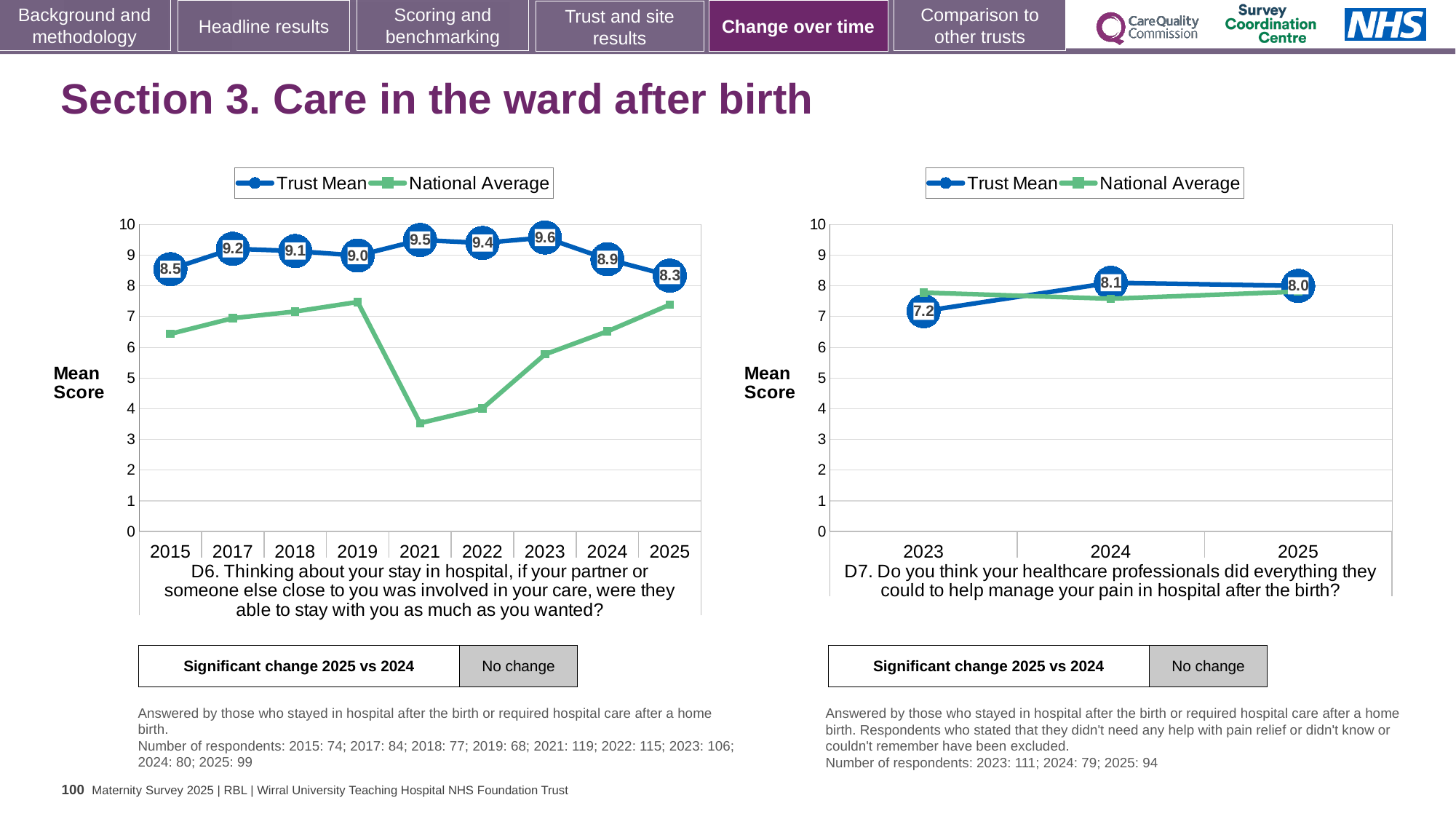
In the D7 chart on the right, what is the difference between the Trust Mean in 2024 and in 2023? 0.9 In the D7 chart on the right, which is larger, the Trust Mean for 2024 or for 2025? 2024 In the D6 chart on the left, how many years are shown on the x axis? 9 In the D6 chart on the left, what is the Trust Mean for 2015? 8.5 How many series does the legend of the D7 chart on the right list? 2 In the D6 chart on the left, what is the Trust Mean for 2023? 9.6 What type of chart is the D6 chart on the left? Line chart In the D6 chart on the left, is the National Average for 2021 greater or less than 4? less In the D6 chart on the left, which year has the lowest Trust Mean? 2025 In the D6 chart on the left, which year has the highest Trust Mean? 2023 In the D7 chart on the right, what is the Trust Mean for 2023? 7.2 In the D6 chart on the left, what is the difference between the Trust Mean in 2024 and in 2025? 0.6